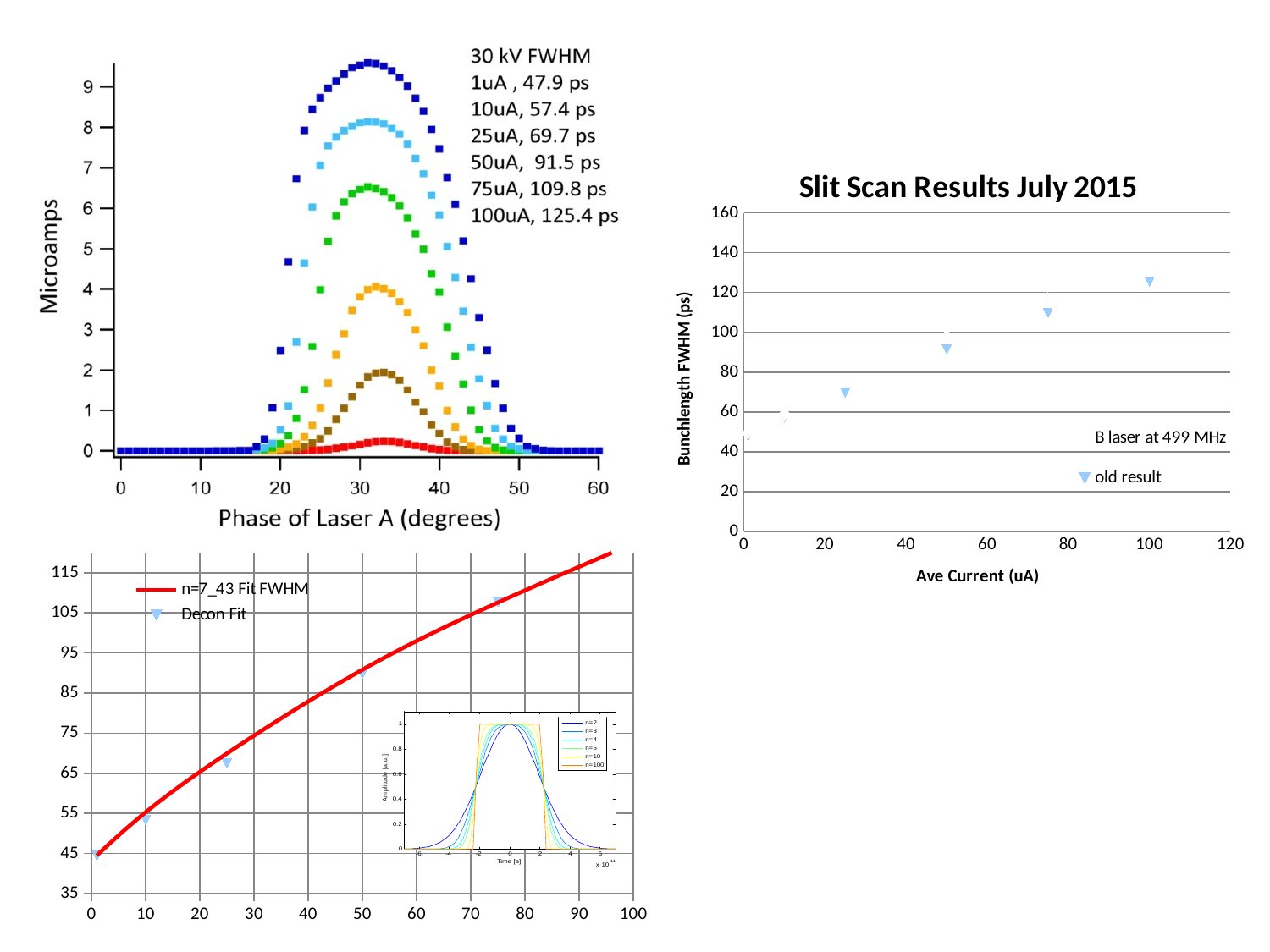
In the top-right chart 'Slit Scan Results July 2015', which is larger: the value at 50 uA or the value at 75 uA? 75 uA In the bottom-left chart, is the Decon Fit value at 25 greater or less than 75? less In the top-right chart 'Slit Scan Results July 2015', is the value at 100 uA greater or less than 120? greater In the top-left chart, what is the x-axis label? Phase of Laser A (degrees) In the top-right chart 'Slit Scan Results July 2015', what is the x-axis label? Ave Current (uA) In the top-left chart, is the peak of the dark blue series greater or less than 9 microamps? greater In the top-right chart 'Slit Scan Results July 2015', do the values rise or fall as average current increases? rise In the bottom-left chart, does the n=7_43 Fit FWHM line rise or fall along the x axis? rise What is the title of the top-right chart? Slit Scan Results July 2015 How many series does the legend of the bottom-left chart list? 2